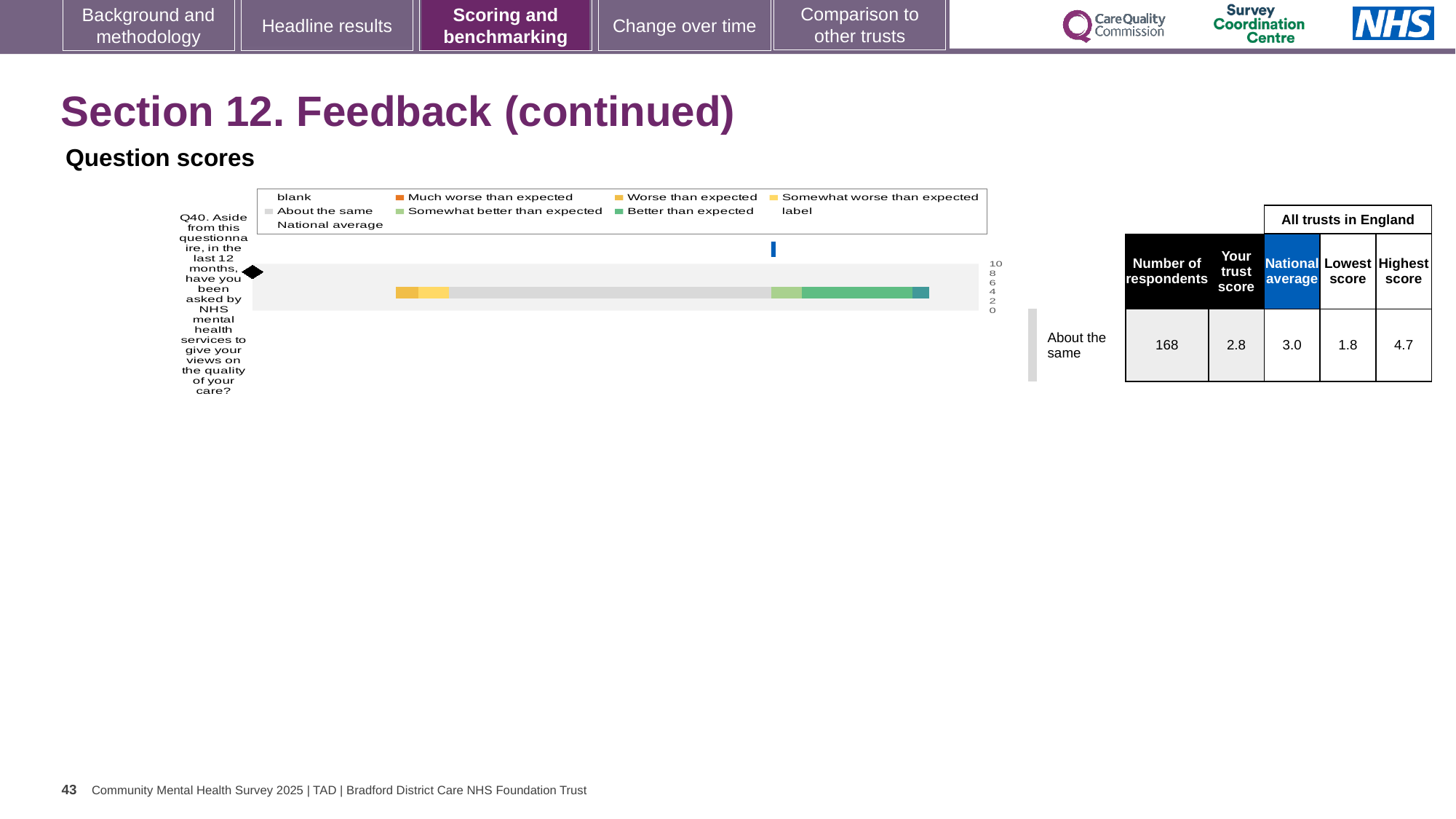
What is the national average score for Q40? 3.0 What is the trust's score for Q40? 2.8 What colour is the 'Better than expected' band in the chart legend? green Which benchmark category is the trust's score for Q40 placed in? About the same What is the difference between the highest and lowest scores among all trusts in England for Q40? 2.9 Which is larger for Q40, the trust's score or the national average? national average Which question number is plotted in the chart? Q40 How many questions are plotted in the chart? 1 What kind of chart is used to show the Q40 question score? bar chart What is the lowest score among all trusts in England for Q40? 1.8 What is the number of respondents for Q40? 168 What is the highest score among all trusts in England for Q40? 4.7